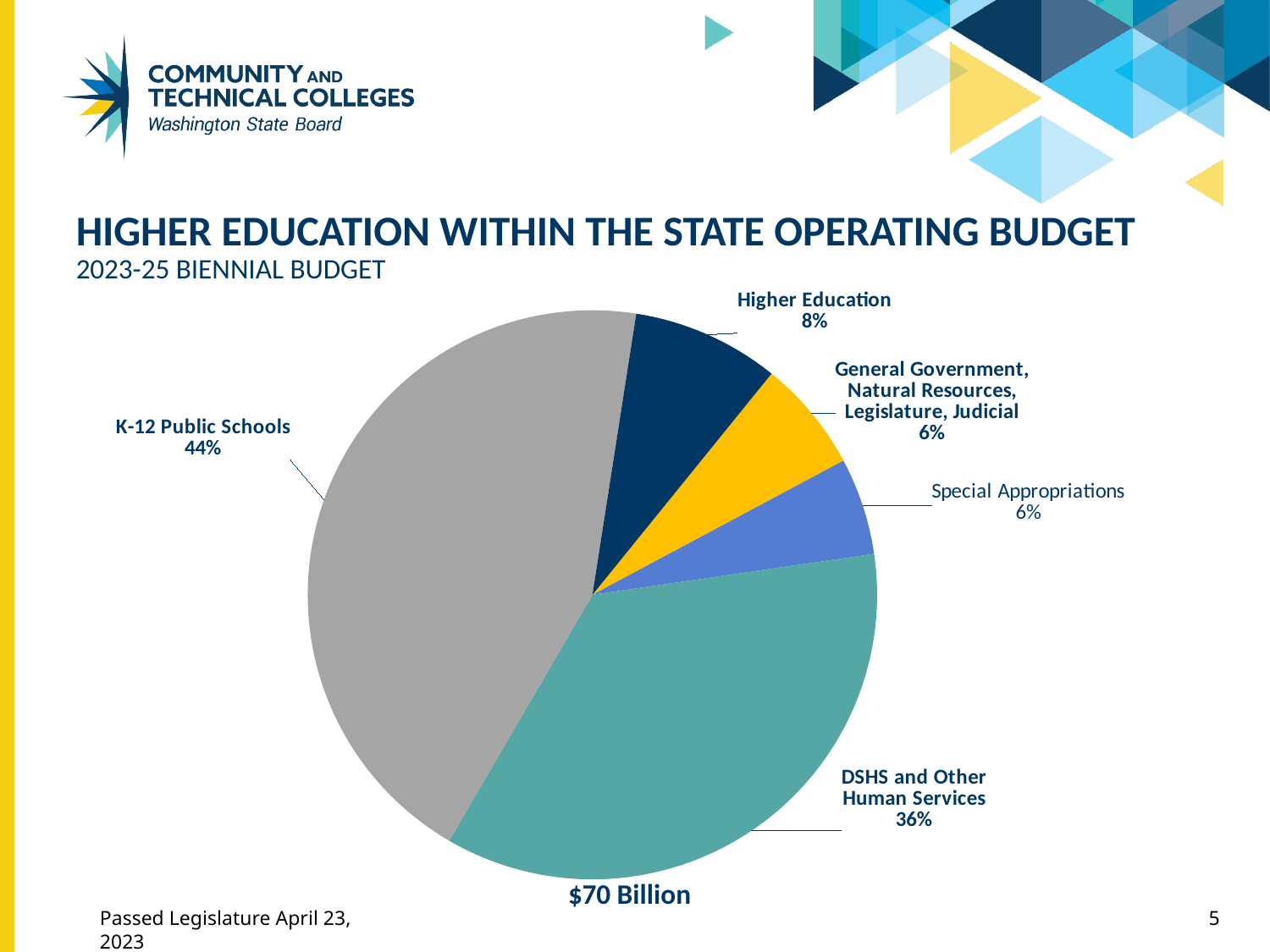
What share of the state operating budget goes to Higher Education? 8% What total budget amount is printed below the pie chart? $70 Billion Which category has the largest share of the state operating budget? K-12 Public Schools What share of the budget goes to General Government, Natural Resources, Legislature, Judicial? 6% What share of the state operating budget goes to Special Appropriations? 6% Which is larger, the share for Higher Education or the share for Special Appropriations? Higher Education What kind of chart is shown on the slide? pie chart How many slices does the pie chart have? 5 What is the difference in percentage points between the K-12 Public Schools share and the DSHS and Other Human Services share? 8 Which biennial budget does the chart cover? 2023-25